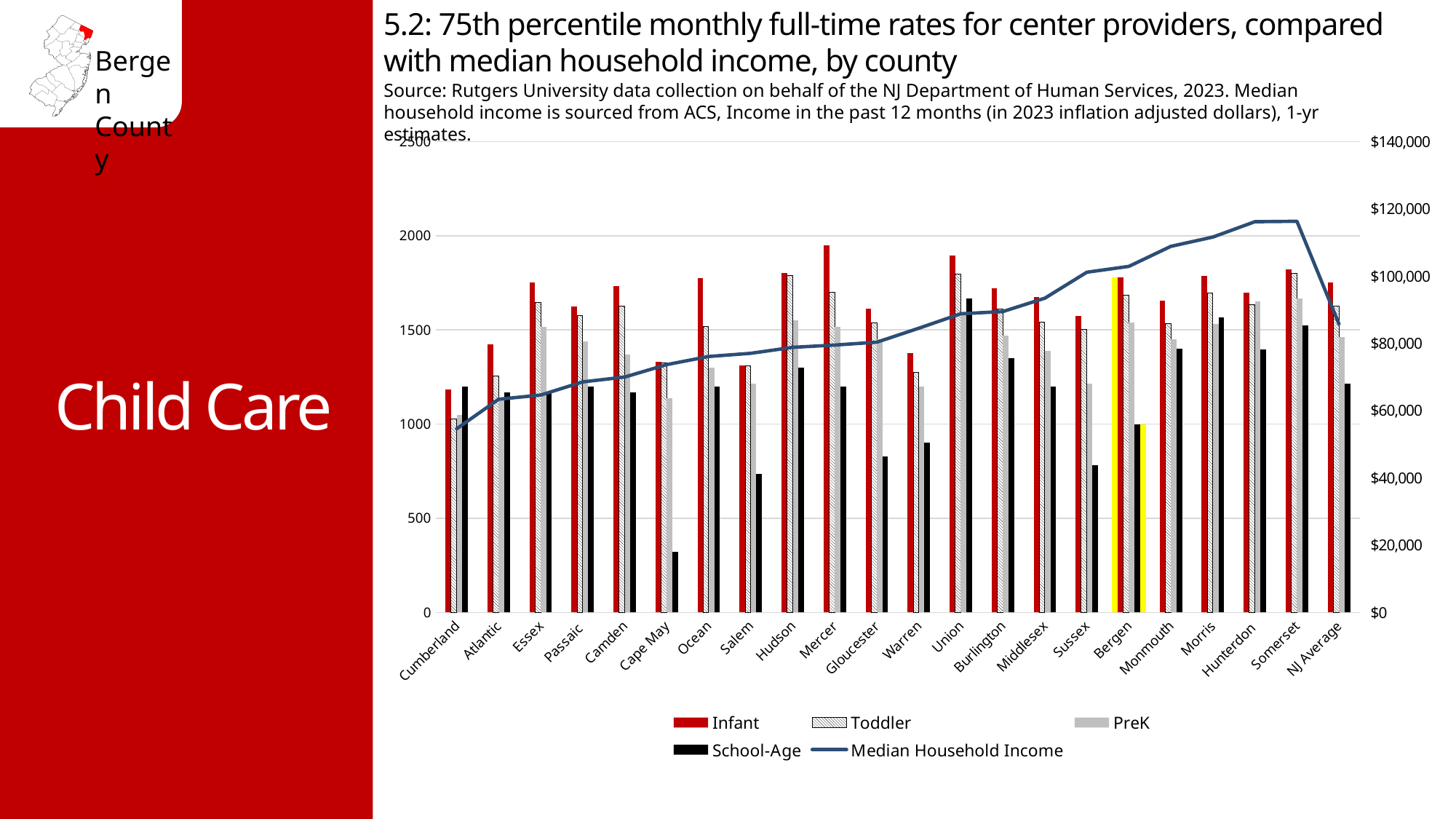
From Cumberland to Somerset, does the Median Household Income line generally rise or fall? rise Which county has the highest Infant rate? Mercer Is the Median Household Income for Somerset greater or less than $100,000? greater How many counties/categories are shown along the x axis of the chart? 22 Which county's bars are highlighted in yellow on the chart? Bergen Is the School-Age value for Cape May greater or less than 500? less Is the Infant value for Cumberland greater or less than 1000? greater Which county has the lowest School-Age rate? Cape May How many series does the chart's legend list? 5 Which county has the lowest Infant rate? Cumberland What kind of chart is shown on the slide? Bar chart with a line series Which is larger, the School-Age value for Union or the School-Age value for Warren? Union